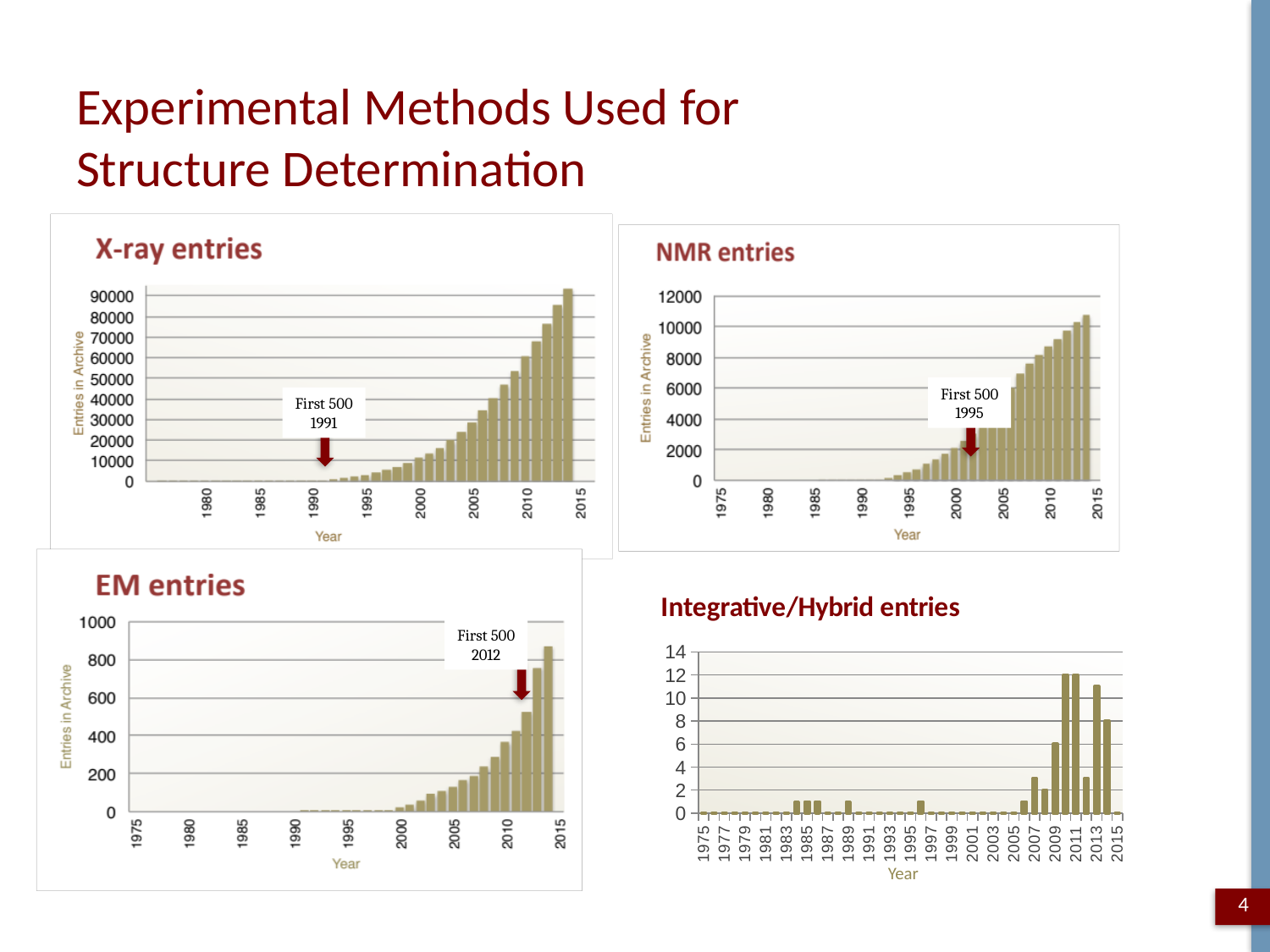
In the Integrative/Hybrid entries chart, what is the value for 2009? 6 In the EM entries chart, do the values rise or fall from 2000 to 2015? rise Which chart shows more entries in 2010, X-ray entries or NMR entries? X-ray entries In the NMR entries chart, is the value for 2005 greater or less than 4000? greater What kind of chart is the X-ray entries chart? bar chart In the NMR entries chart, in which year were the first 500 entries reached according to the annotation? 1995 In the X-ray entries chart, in which year were the first 500 entries reached according to the annotation? 1991 In the X-ray entries chart, is the value for 2010 greater or less than 60000? greater In the Integrative/Hybrid entries chart, what is the highest value reached by any bar? 12 In the EM entries chart, is the value for 2013 greater or less than 600? greater In the X-ray entries chart, do the values rise or fall from 1975 to 2015? rise